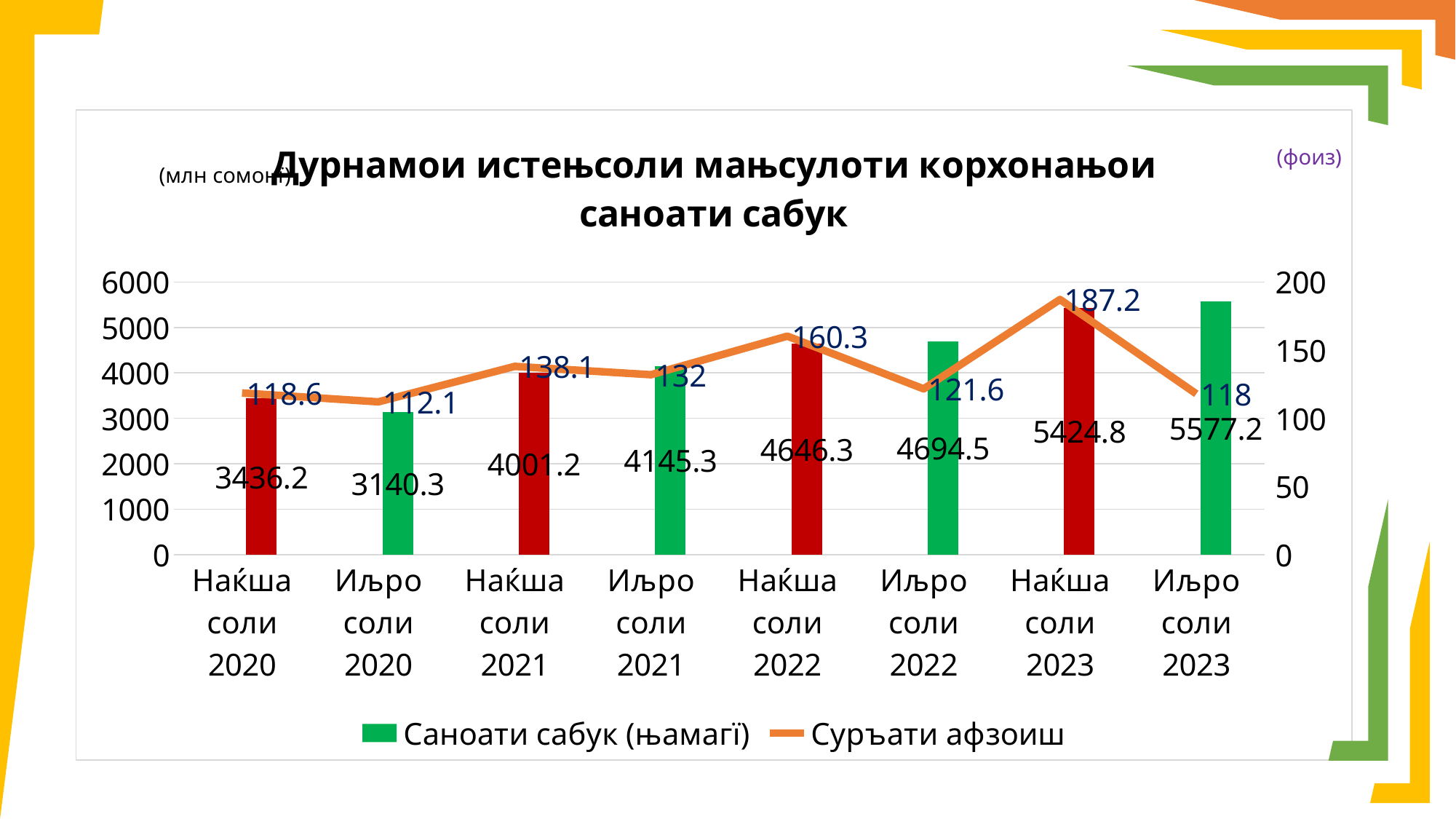
How many series does the legend list? 2 Which category has the lowest Саноати сабук (њамагї) bar? Иљро соли 2020 What kind of chart is this? Combined bar and line chart What is the difference between the Саноати сабук (њамагї) values for Иљро соли 2023 and Наќша соли 2023? 152.4 What is the title of the chart? Дурнамои истењсоли мањсулоти корхонањои саноати сабук How many categories are shown on the x axis? 8 What is the Суръати афзоиш value for Наќша соли 2023? 187.2 What is the value of the Саноати сабук (њамагї) bar for Иљро соли 2023? 5577.2 Which category has the highest Суръати афзоиш value? Наќша соли 2023 What is the Саноати сабук (њамагї) value for Иљро соли 2020? 3140.3 Do the Саноати сабук (њамагї) values generally rise or fall from Наќша соли 2020 to Иљро соли 2023? Rise Which is larger, the Саноати сабук (њамагї) value for Наќша соли 2021 or for Иљро соли 2021? Иљро соли 2021